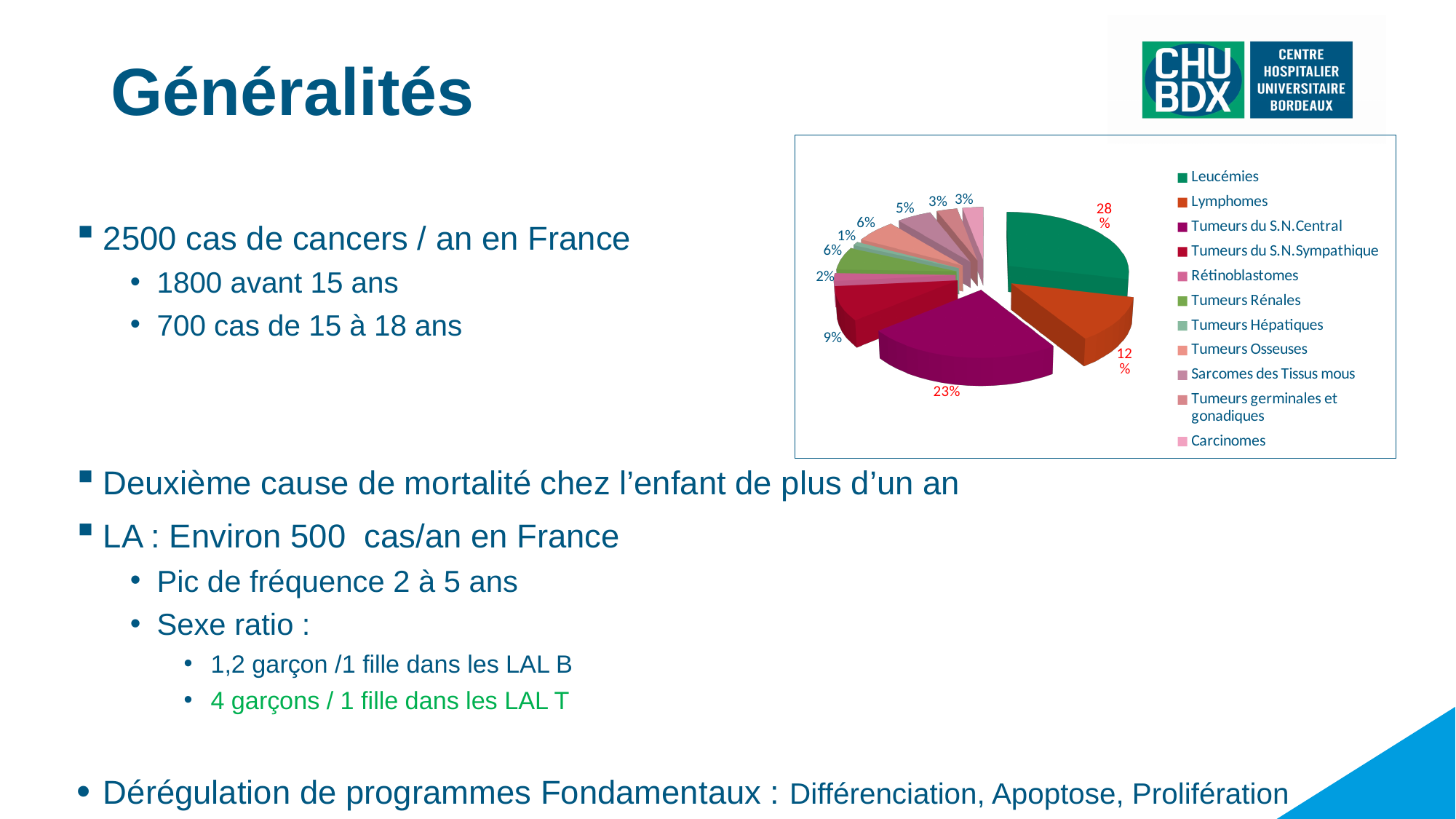
What percentage of the pie chart is Tumeurs du S.N.Sympathique? 9% What colour is the Leucémies slice in the pie chart? green What percentage of the pie chart is Tumeurs du S.N.Central? 23% Which is larger in the pie chart, Lymphomes or Tumeurs du S.N.Sympathique? Lymphomes How many categories does the legend of the pie chart list? 11 What percentage of the pie chart is Leucémies? 28% What kind of chart is shown on the slide? pie chart Which category has the smallest share of the pie chart? Tumeurs Hépatiques What percentage of the pie chart is Sarcomes des Tissus mous? 5% What percentage of the pie chart is Lymphomes? 12% Which category has the largest share of the pie chart? Leucémies What is the difference in percentage points between Leucémies and Tumeurs du S.N.Central? 5